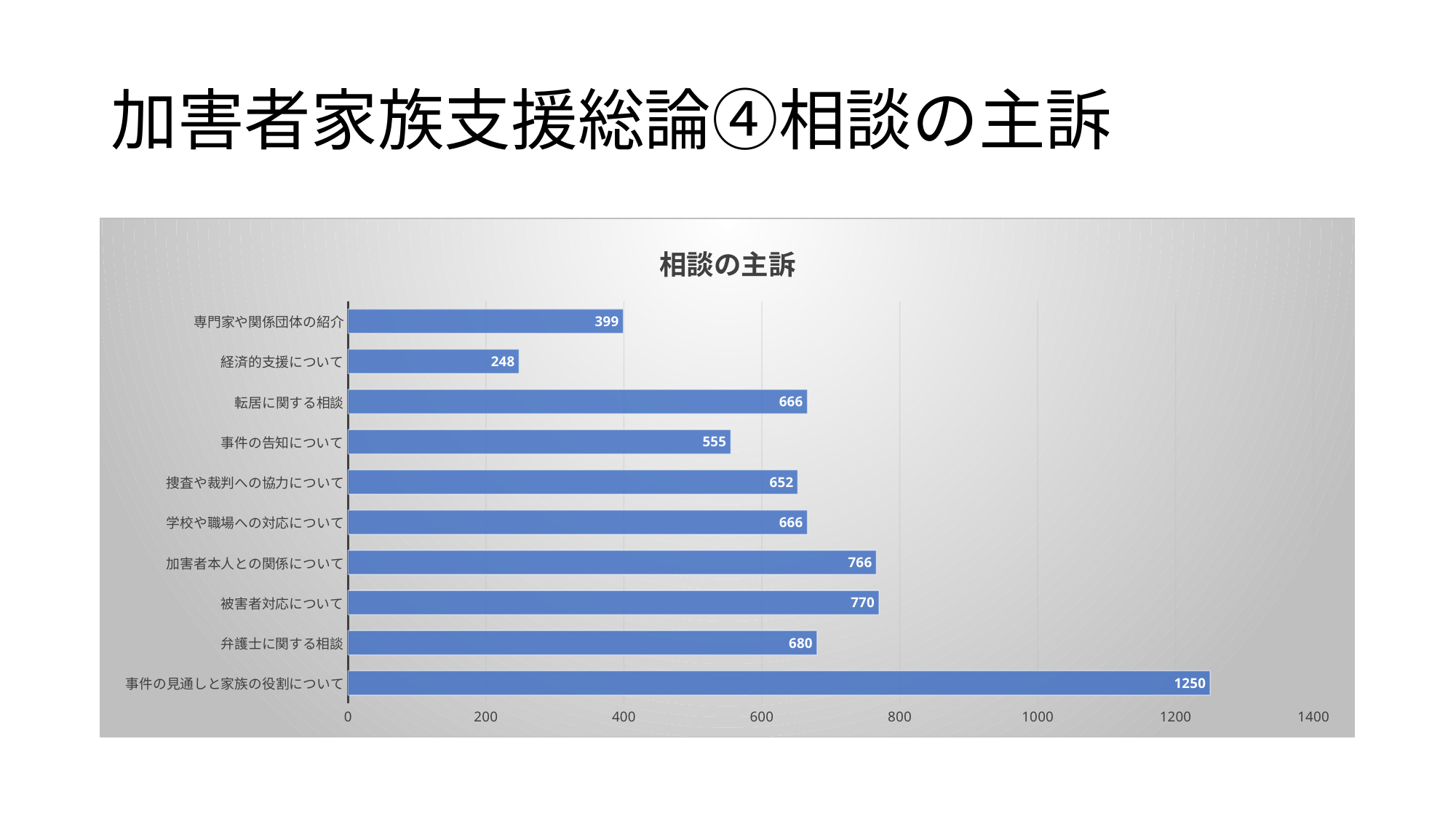
Is the value for 捜査や裁判への協力について greater or less than 600? greater Which category has the lowest value? 経済的支援について What is the title of the chart? 相談の主訴 What is the value for 経済的支援について? 248 What is the value for 事件の告知について? 555 What type of chart is shown on the slide? Bar chart Which is larger, the value for 専門家や関係団体の紹介 or the value for 転居に関する相談? 転居に関する相談 How many categories are plotted in the chart? 10 Which category has the highest value? 事件の見通しと家族の役割について What is the value for 事件の見通しと家族の役割について? 1250 What is the difference between the values for 事件の見通しと家族の役割について and 被害者対応について? 480 What is the value for 弁護士に関する相談? 680